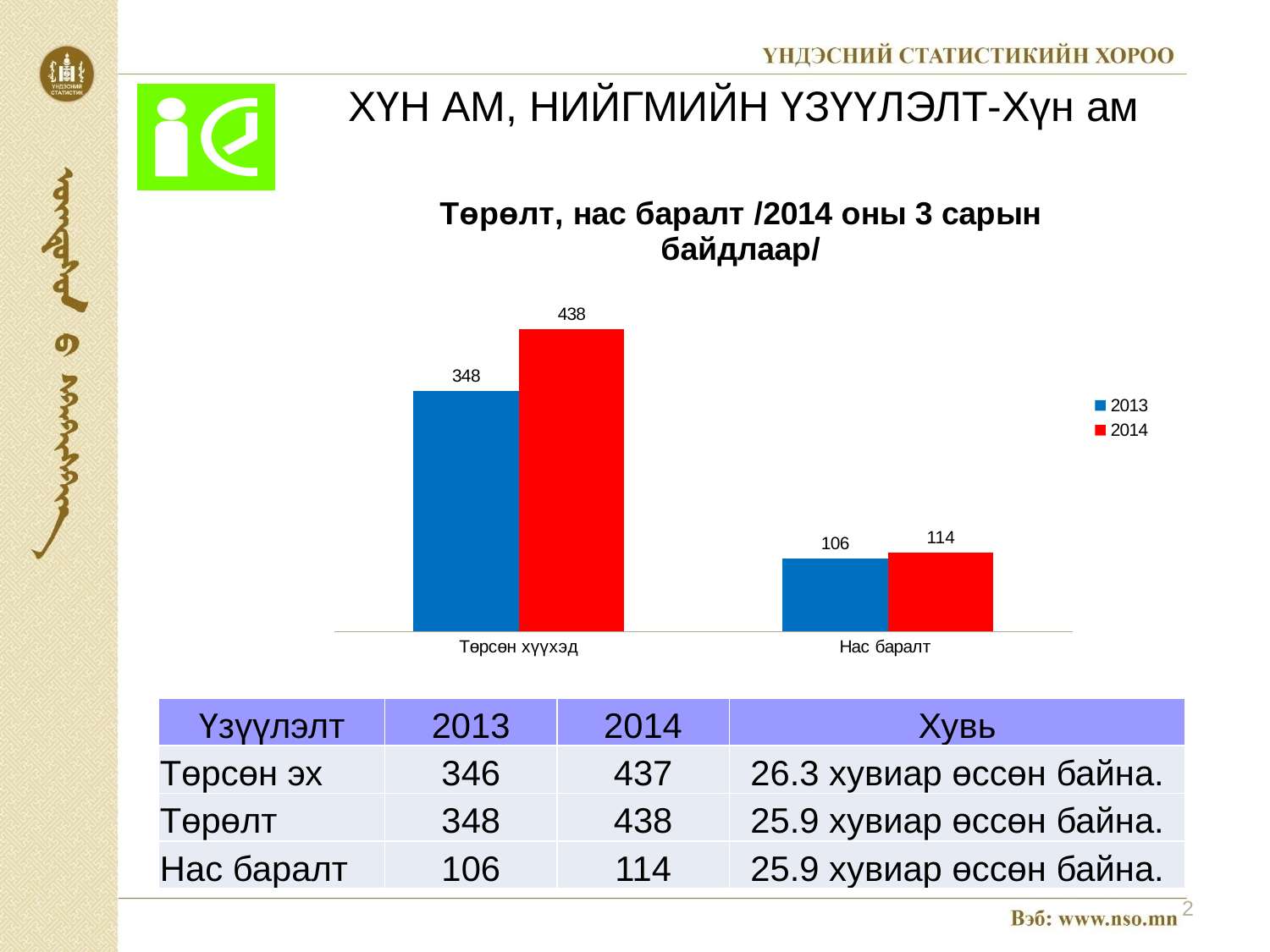
What is the difference between the 2014 and 2013 values for Төрсөн хүүхэд? 90 Which is larger for Нас баралт: the 2013 value or the 2014 value? 2014 Which category has the lowest 2013 value? Нас баралт Which category has the highest 2014 value? Төрсөн хүүхэд What kind of chart is shown on the slide? Bar chart What is the difference between the 2014 and 2013 values for Нас баралт? 8 What is the 2014 value for Нас баралт? 114 How many series does the legend list? 2 What is the 2013 value for Нас баралт? 106 How many categories are shown on the x axis? 2 What is the 2013 value for Төрсөн хүүхэд? 348 What is the 2014 value for Төрсөн хүүхэд? 438